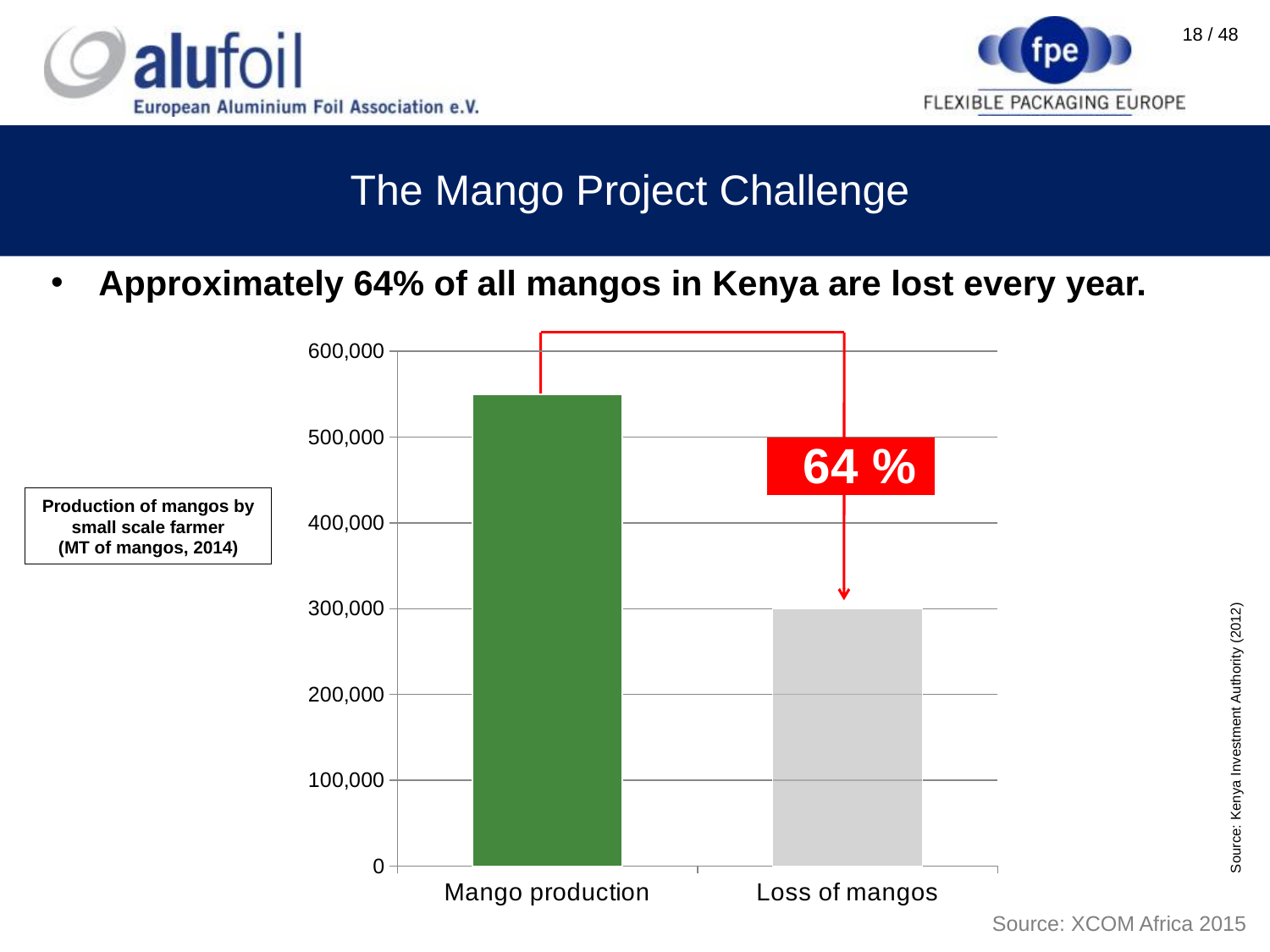
Which category has the highest bar in the chart? Mango production Is the value for Mango production greater or less than 500,000? greater Which category has the lowest bar in the chart? Loss of mangos Is the value for Loss of mangos greater or less than 200,000? greater Is the value for Mango production greater or less than 600,000? less What kind of chart is shown on the slide? bar chart Which is larger, the bar for Mango production or the bar for Loss of mangos? Mango production What percentage is shown in the red label between the two bars? 64 % What colour is the bar for Mango production? green How many categories are plotted on the x axis of the chart? 2